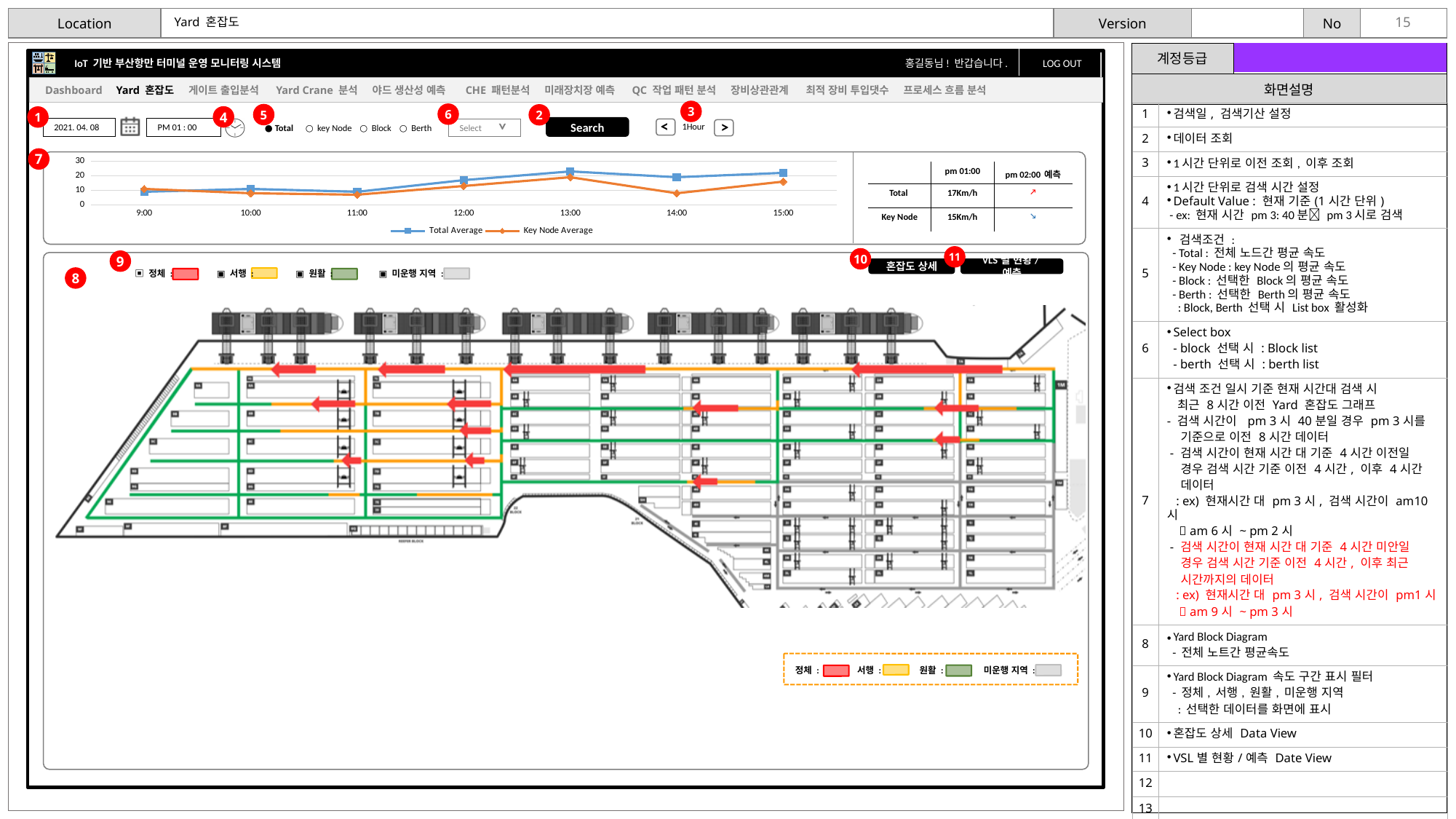
What kind of chart is shown at the top of the dashboard? line chart Does the Total Average series rise or fall from 11:00 to 13:00? rise At 14:00, which series has the larger value, Total Average or Key Node Average? Total Average Is the Total Average value at 13:00 greater or less than 20? greater Is the Total Average value at 11:00 greater or less than 20? less At which time does the Key Node Average series reach its highest value? 13:00 What are the two series named in the line chart's legend? Total Average and Key Node Average How many time points are plotted along the x axis of the line chart? 7 Is the Key Node Average value at 14:00 greater or less than 10? less What is the first time label on the x axis of the line chart? 9:00 How many series does the legend of the line chart list? 2